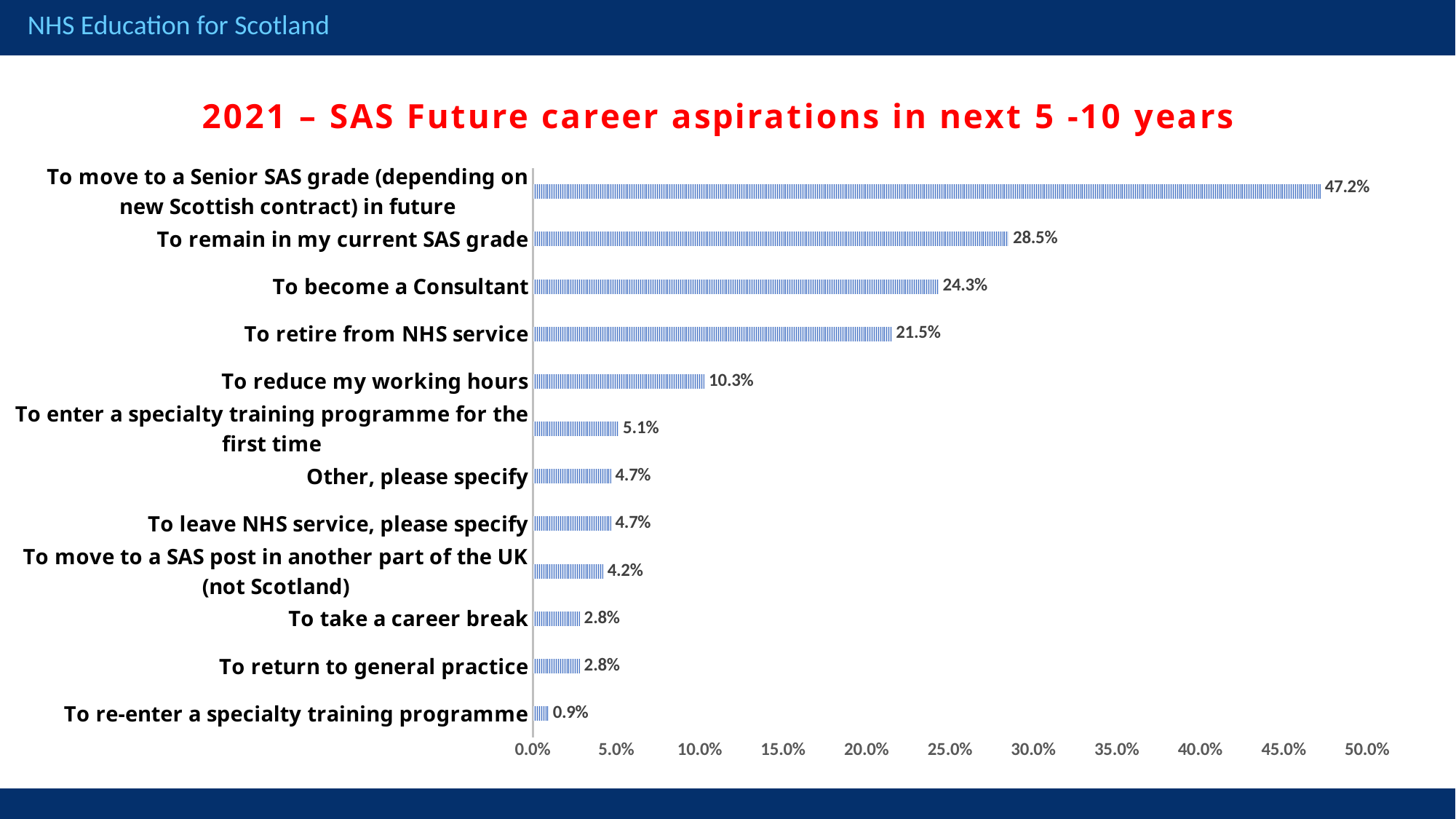
Is the value for 'To remain in my current SAS grade' greater or less than 25.0%? greater What is the maximum value shown on the x axis? 50.0% What percentage chose 'To reduce my working hours'? 10.3% What percentage of respondents aspire to become a Consultant? 24.3% Which is larger: 'To become a Consultant' or 'To retire from NHS service'? To become a Consultant What is the difference between 'To move to a Senior SAS grade (depending on new Scottish contract) in future' and 'To remain in my current SAS grade'? 18.7% How many career aspiration categories are shown in the chart? 12 Which career aspiration has the lowest percentage? To re-enter a specialty training programme Which career aspiration has the highest percentage? To move to a Senior SAS grade (depending on new Scottish contract) in future What type of chart is shown on the slide? Bar chart What is the value for 'To retire from NHS service'? 21.5% What is the title of the chart? 2021 – SAS Future career aspirations in next 5 -10 years